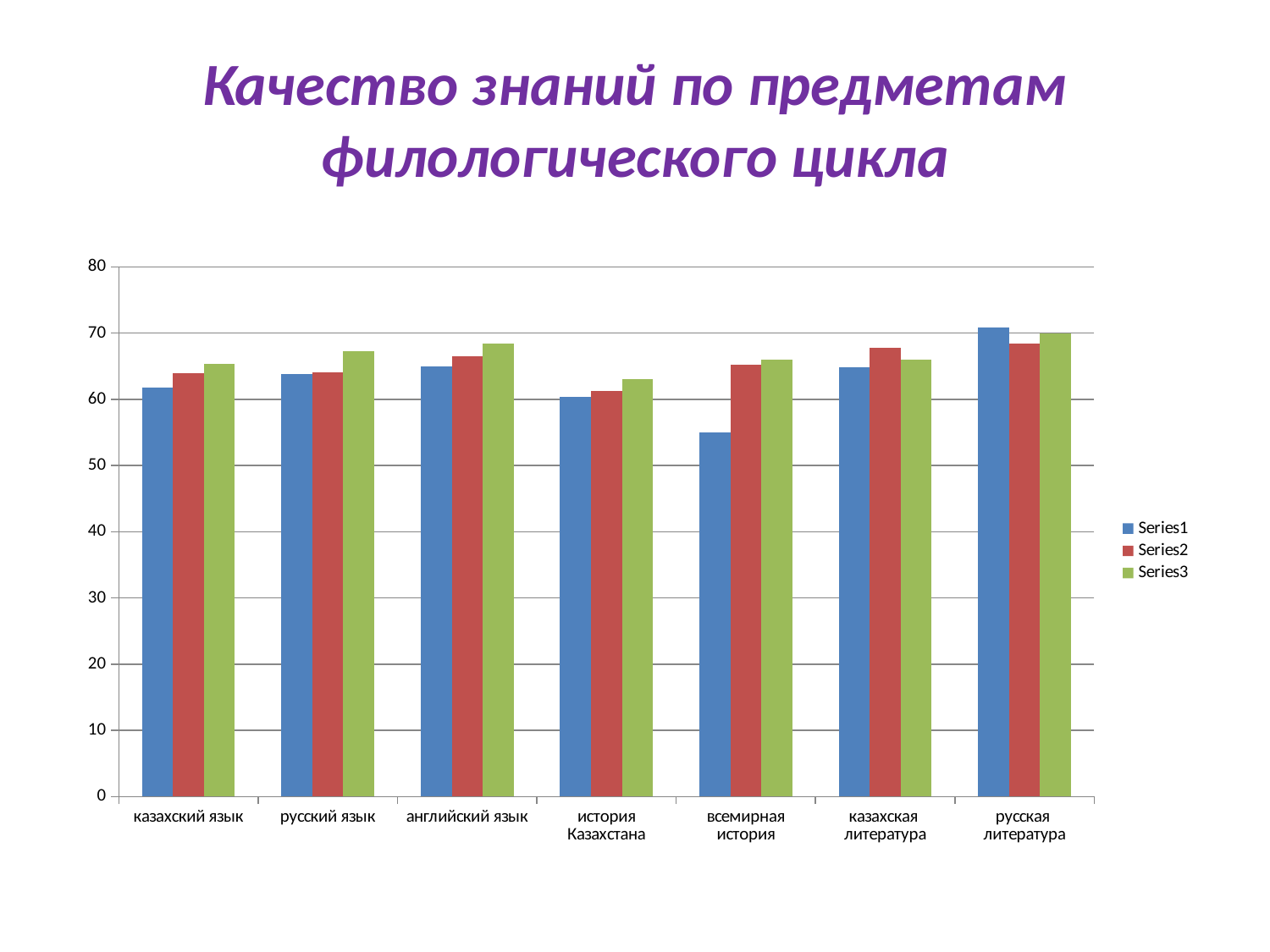
For всемирная история, which is larger: the Series1 value or the Series3 value? Series3 How many subject categories are shown on the x axis? 7 Which category has the highest Series1 value? русская литература Is the Series3 value for английский язык greater or less than 60? greater Which is larger: the Series1 value for русская литература or the Series1 value for казахский язык? русская литература How many series does the legend list? 3 Which category has the lowest Series1 value? всемирная история Is the Series1 value for всемирная история greater or less than 60? less What is the title of the slide? Качество знаний по предметам филологического цикла What kind of chart is shown on the slide? bar chart Which category has the lowest Series3 value? история Казахстана